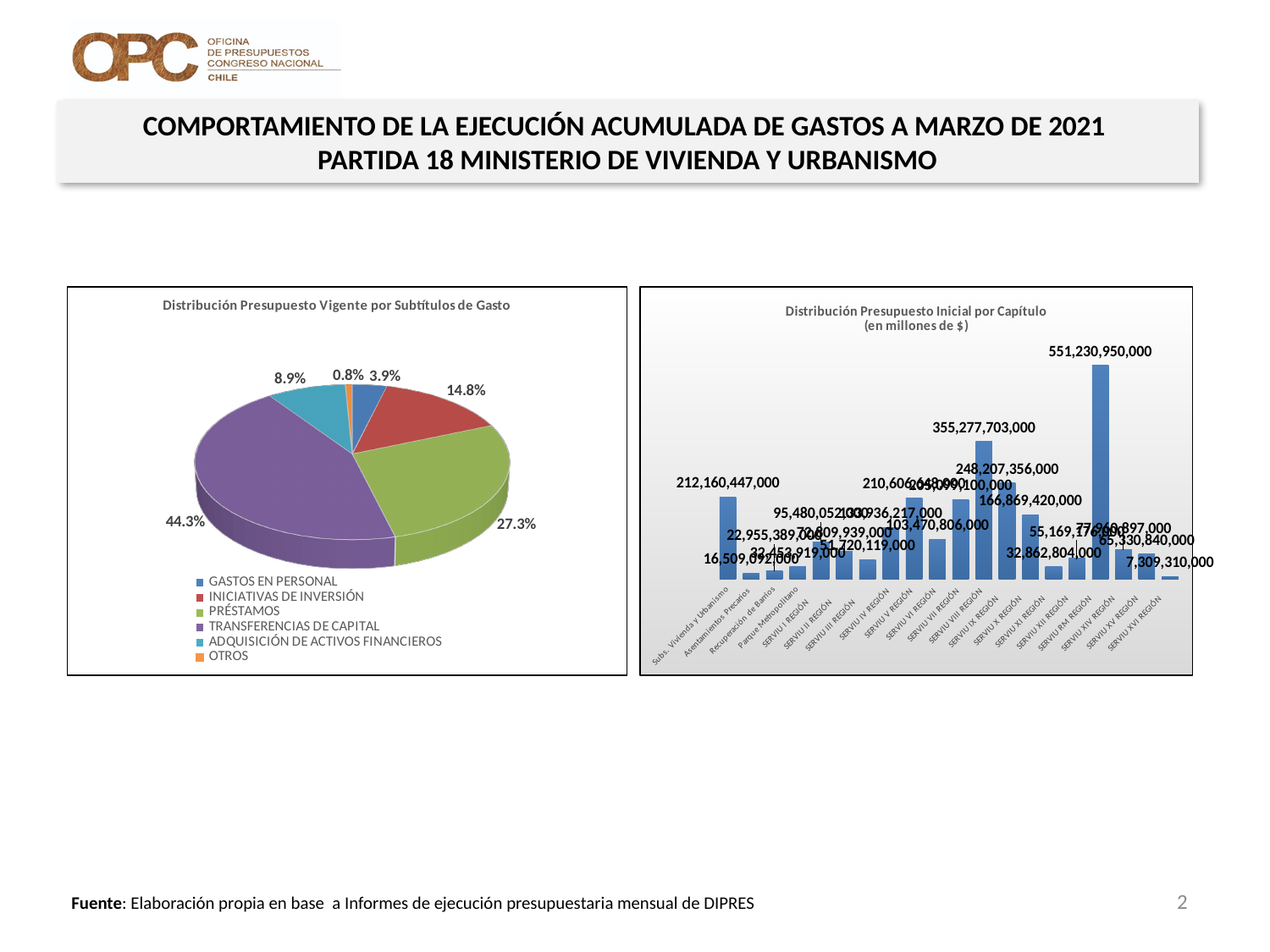
In the bar chart 'Distribución Presupuesto Inicial por Capítulo', what is the difference between the values for SERVIU RM REGIÓN and SERVIU VIII REGIÓN? 195,953,247,000 In the bar chart 'Distribución Presupuesto Inicial por Capítulo', what is the value for SERVIU RM REGIÓN? 551,230,950,000 In the pie chart 'Distribución Presupuesto Vigente por Subtítulos de Gasto', what share does TRANSFERENCIAS DE CAPITAL have? 44.3% What kind of chart is the chart on the right, 'Distribución Presupuesto Inicial por Capítulo'? Bar chart In the pie chart 'Distribución Presupuesto Vigente por Subtítulos de Gasto', how many categories does the legend list? 6 In the pie chart 'Distribución Presupuesto Vigente por Subtítulos de Gasto', which is larger: INICIATIVAS DE INVERSIÓN or ADQUISICIÓN DE ACTIVOS FINANCIEROS? INICIATIVAS DE INVERSIÓN In the pie chart 'Distribución Presupuesto Vigente por Subtítulos de Gasto', which category has the largest share? TRANSFERENCIAS DE CAPITAL In the bar chart 'Distribución Presupuesto Inicial por Capítulo', what is the value for Subs. Vivienda y Urbanismo? 212,160,447,000 In the pie chart 'Distribución Presupuesto Vigente por Subtítulos de Gasto', what share does PRÉSTAMOS have? 27.3% In the pie chart 'Distribución Presupuesto Vigente por Subtítulos de Gasto', which category has the smallest share? OTROS In the bar chart 'Distribución Presupuesto Inicial por Capítulo', what is the value for SERVIU VIII REGIÓN? 355,277,703,000 In the bar chart 'Distribución Presupuesto Inicial por Capítulo', which capítulo has the highest value? SERVIU RM REGIÓN